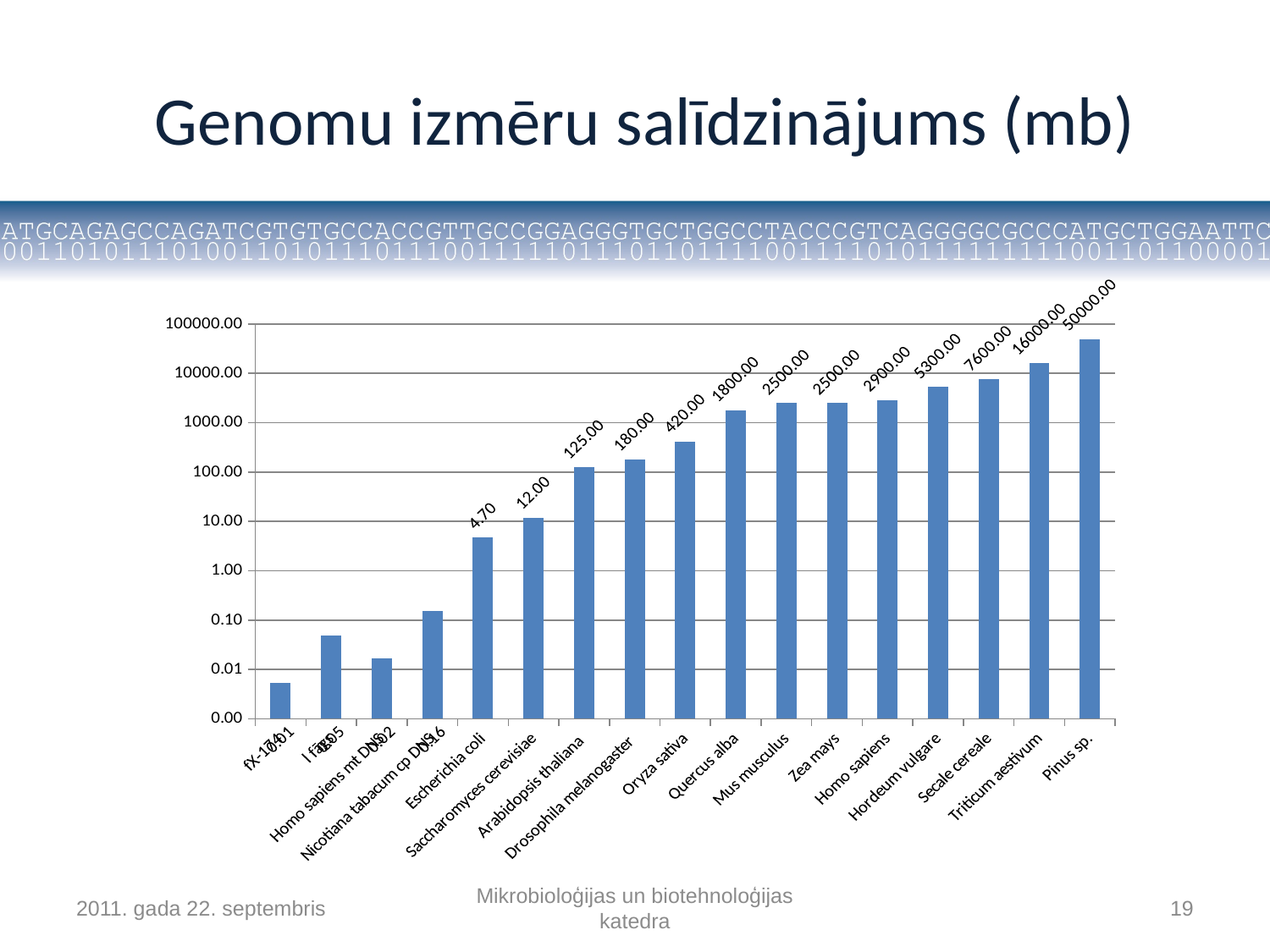
How many categories are shown on the x axis? 17 What is the value for Pinus sp.? 50000.00 Which is larger, the value for Hordeum vulgare or the value for Homo sapiens? Hordeum vulgare Is the value for Nicotiana tabacum cp DNS greater or less than 1.00? less Which category has the lowest value? fX-174 What is the difference between the values for Triticum aestivum and Secale cereale? 8400.00 What kind of chart is shown on the slide? bar chart Do the values generally rise or fall from left to right along the x axis? rise Which category has the highest value? Pinus sp. What is the value for Homo sapiens? 2900.00 What is the value for Escherichia coli? 4.70 What is the difference between the values for Drosophila melanogaster and Arabidopsis thaliana? 55.00